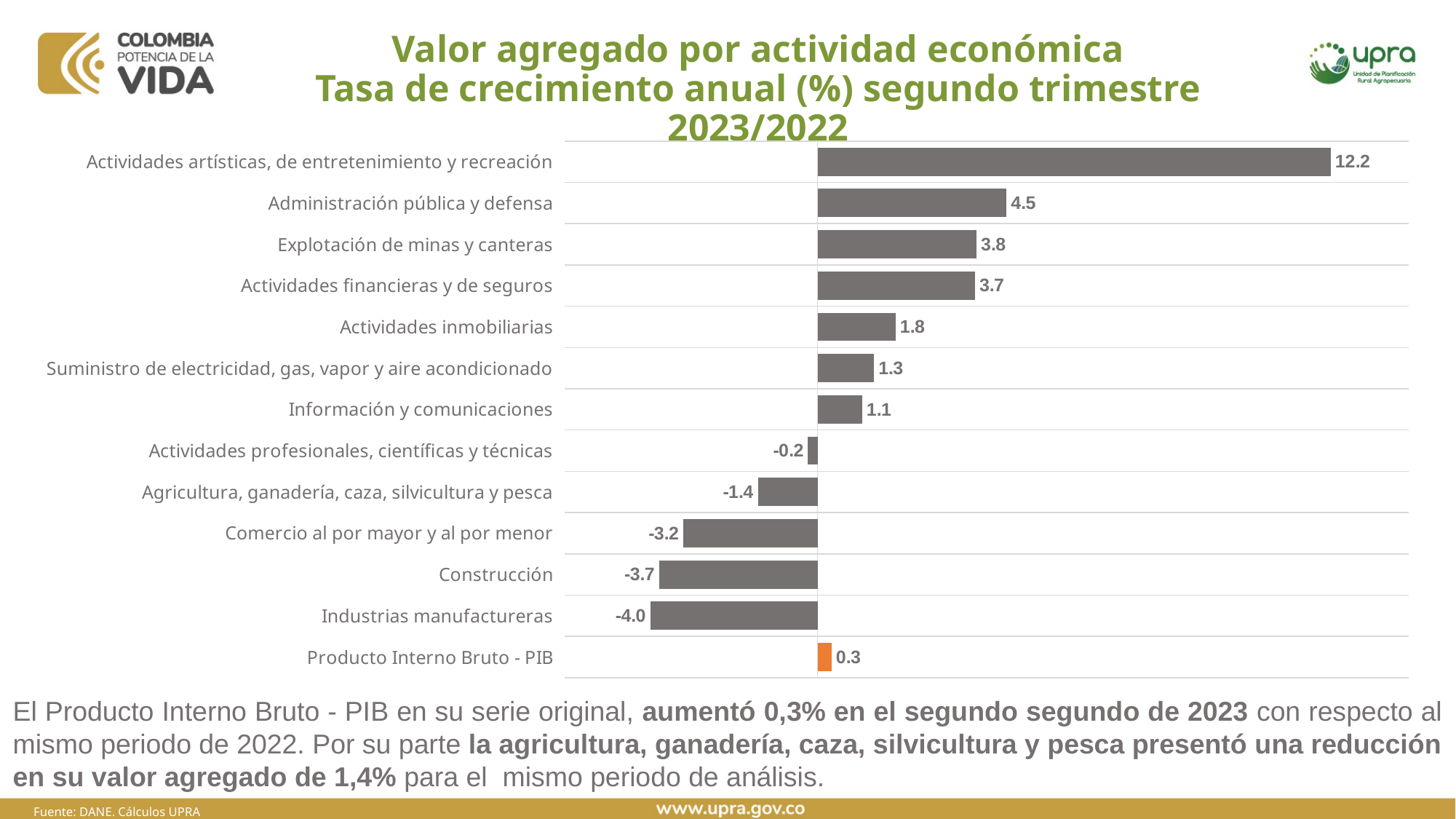
Which is larger, the value for Actividades inmobiliarias or the value for Información y comunicaciones? Actividades inmobiliarias How many categories are shown in the chart? 13 What is the difference between the values for Administración pública y defensa and Explotación de minas y canteras? 0.7 What is the value for Agricultura, ganadería, caza, silvicultura y pesca? -1.4 Which bar is shown in a different colour (orange) from the others? Producto Interno Bruto - PIB What kind of chart is shown on the slide? Bar chart Which category has the lowest value? Industrias manufactureras What is the value for Producto Interno Bruto - PIB? 0.3 What is the value for Actividades artísticas, de entretenimiento y recreación? 12.2 What is the value for Industrias manufactureras? -4.0 How many categories have a negative value? 5 Which category has the highest value? Actividades artísticas, de entretenimiento y recreación